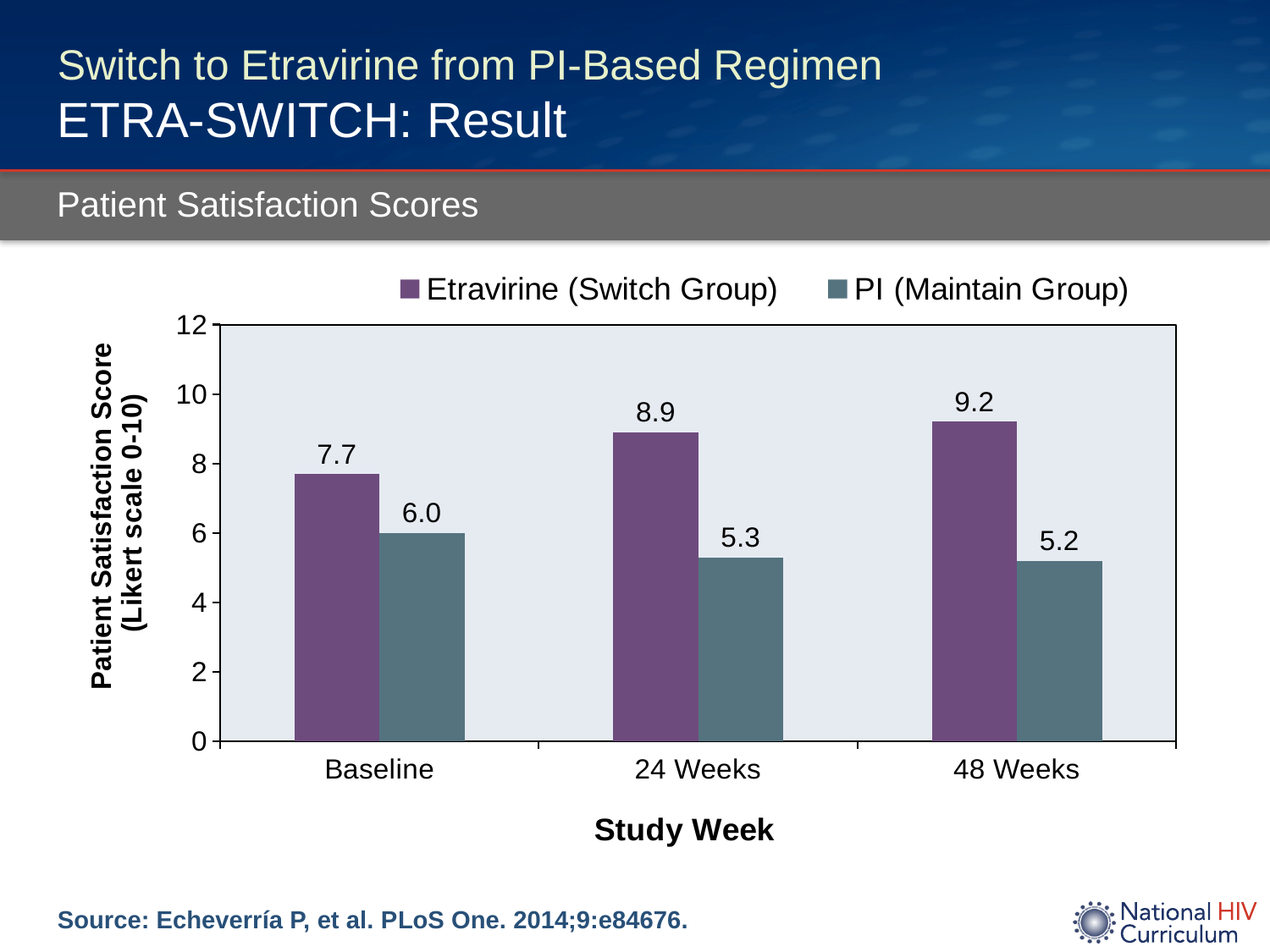
What kind of chart is shown on the slide? Bar chart Which group has the higher satisfaction score at 24 Weeks? Etravirine (Switch Group) What is the difference between the Etravirine (Switch Group) and PI (Maintain Group) scores at 48 Weeks? 4.0 How many study week categories are shown on the x axis? 3 What is the patient satisfaction score for the Etravirine (Switch Group) at 48 Weeks? 9.2 Is the PI (Maintain Group) score at Baseline greater or less than 8? less What is the patient satisfaction score for the PI (Maintain Group) at 24 Weeks? 5.3 Do the Etravirine (Switch Group) scores rise or fall from Baseline to 48 Weeks? Rise What is the patient satisfaction score for the Etravirine (Switch Group) at Baseline? 7.7 How many series does the legend list? 2 At which study week is the PI (Maintain Group) score lowest? 48 Weeks At which study week is the Etravirine (Switch Group) score highest? 48 Weeks